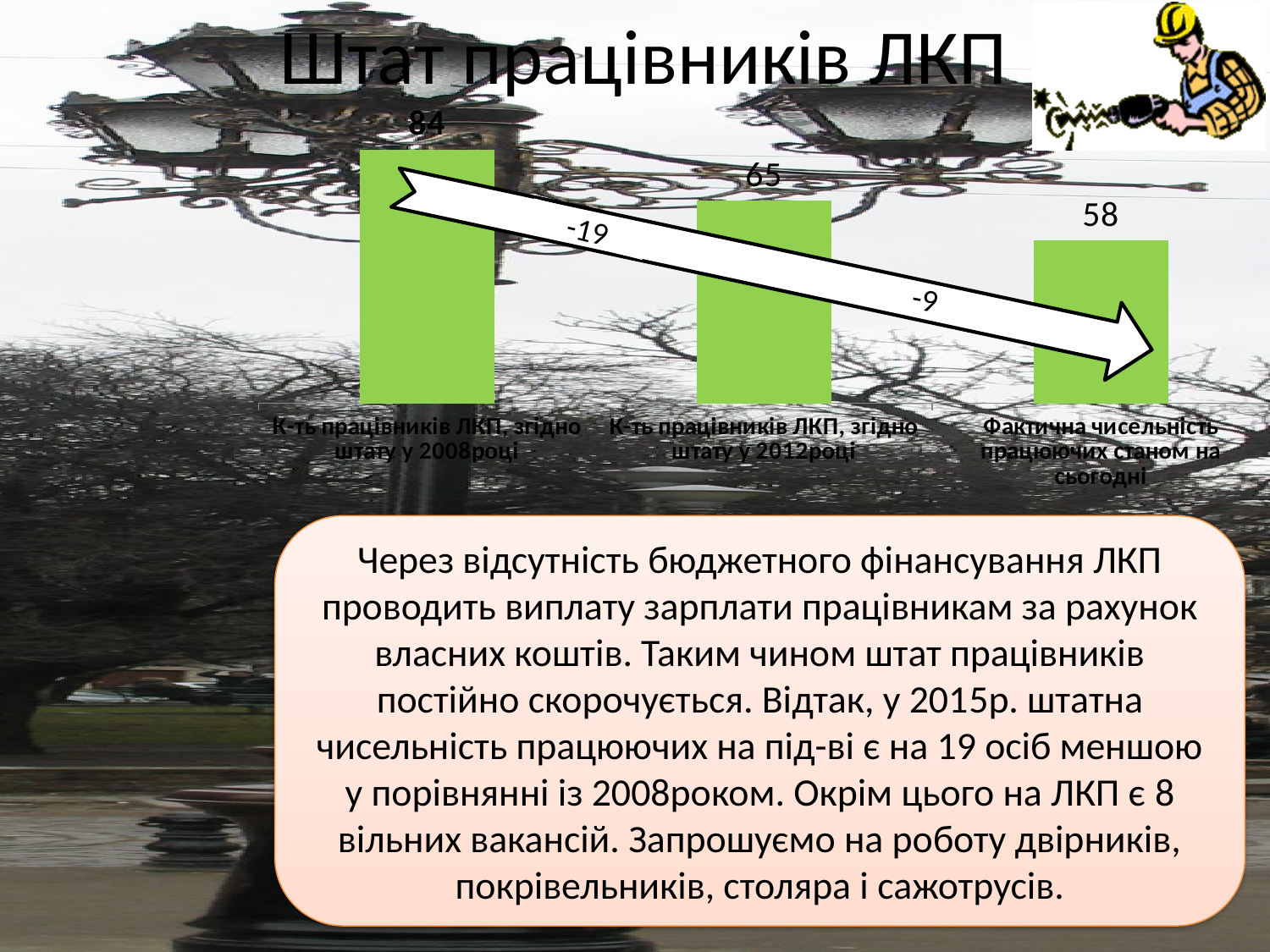
What is the value for 'К-ть працівників ЛКП, згідно штату у 2012році'? 65 Do the values rise or fall from left to right across the chart? Fall What is the title of the slide containing the chart? Штат працівників ЛКП Which category has the lowest value? Фактична чисельність працюючих станом на сьогодні Which category has the highest value? К-ть працівників ЛКП, згідно штату у 2008році What is the value for 'К-ть працівників ЛКП, згідно штату у 2008році'? 84 What kind of chart is shown on the slide? Bar chart What is the value for 'Фактична чисельність працюючих станом на сьогодні'? 58 Which is larger: the value for 2012 or the current actual number of employees? 2012 How many bars are shown in the chart? 3 What is the difference between the 2008 staff count and the 2012 staff count? 19